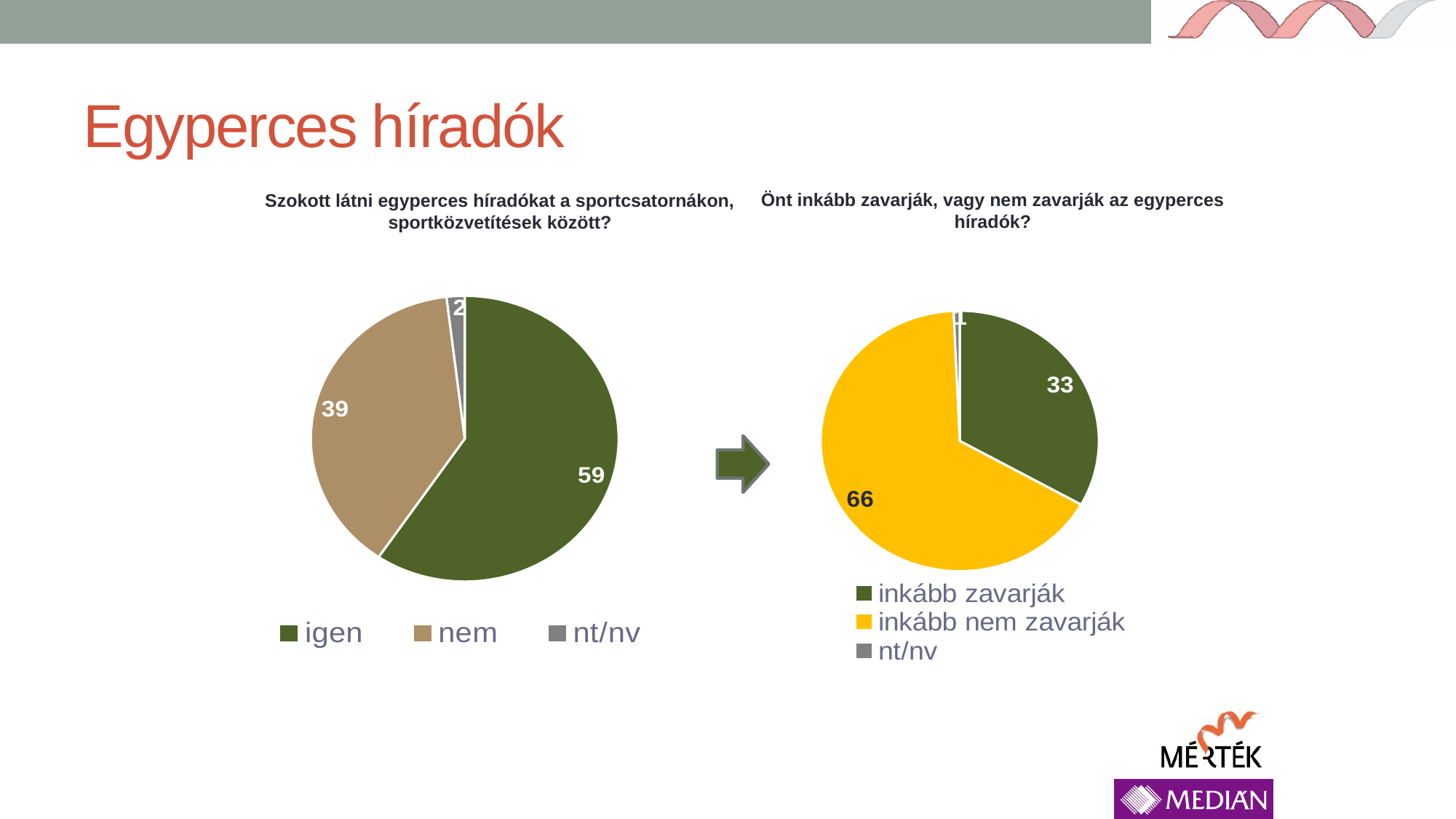
In the left chart ("Szokott látni egyperces híradókat..."), what is the difference between the values for "igen" and "nem"? 20 In the right chart ("Önt inkább zavarják..."), what is the difference between the values for "inkább nem zavarják" and "inkább zavarják"? 33 In the left chart ("Szokott látni egyperces híradókat..."), what is the value for "nem"? 39 In the left chart ("Szokott látni egyperces híradókat..."), what is the value for "igen"? 59 How many entries does the legend of the right chart ("Önt inkább zavarják...") list? 3 In the left chart ("Szokott látni egyperces híradókat..."), which category has the smallest slice? nt/nv In the right chart ("Önt inkább zavarják..."), what is the value for "inkább zavarják"? 33 In the left chart ("Szokott látni egyperces híradókat..."), what is the value for "nt/nv"? 2 In the left chart ("Szokott látni egyperces híradókat..."), which category has the largest slice? igen In the right chart ("Önt inkább zavarják..."), which is larger: "inkább zavarják" or "inkább nem zavarják"? inkább nem zavarják What type of chart is the left chart ("Szokott látni egyperces híradókat...")? pie chart In the right chart ("Önt inkább zavarják..."), what is the value for "inkább nem zavarják"? 66